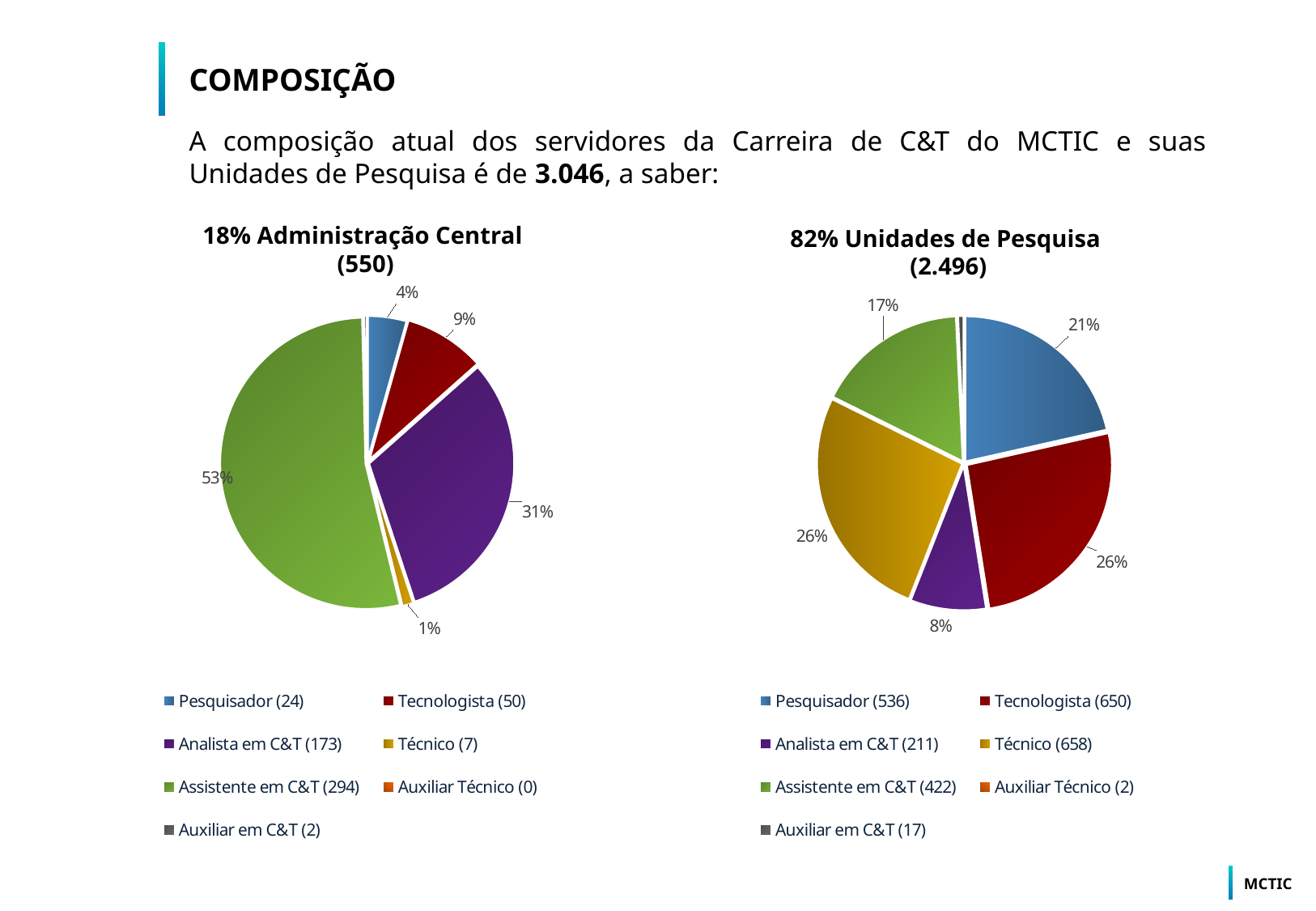
In the '18% Administração Central (550)' chart, what is the difference in percentage points between the Assistente em C&T slice and the Analista em C&T slice? 22 percentage points In the '18% Administração Central (550)' chart, what share of the pie does Assistente em C&T hold? 53% In the '82% Unidades de Pesquisa (2.496)' chart, what share of the pie does Pesquisador hold? 21% In the '82% Unidades de Pesquisa (2.496)' chart, which is larger, the Tecnologista slice or the Analista em C&T slice? Tecnologista In the '82% Unidades de Pesquisa (2.496)' chart, how many servidores are listed for Técnico in the legend? 658 In the '82% Unidades de Pesquisa (2.496)' chart, which category has the smallest slice? Auxiliar Técnico In the '18% Administração Central (550)' chart, how many servidores are listed for Analista em C&T in the legend? 173 What type of chart is used on the left side of the slide? Pie chart In the '18% Administração Central (550)' chart, what share of the pie does Analista em C&T hold? 31% How many categories does the legend of the '82% Unidades de Pesquisa (2.496)' chart list? 7 In the '18% Administração Central (550)' chart, which category has the largest slice? Assistente em C&T